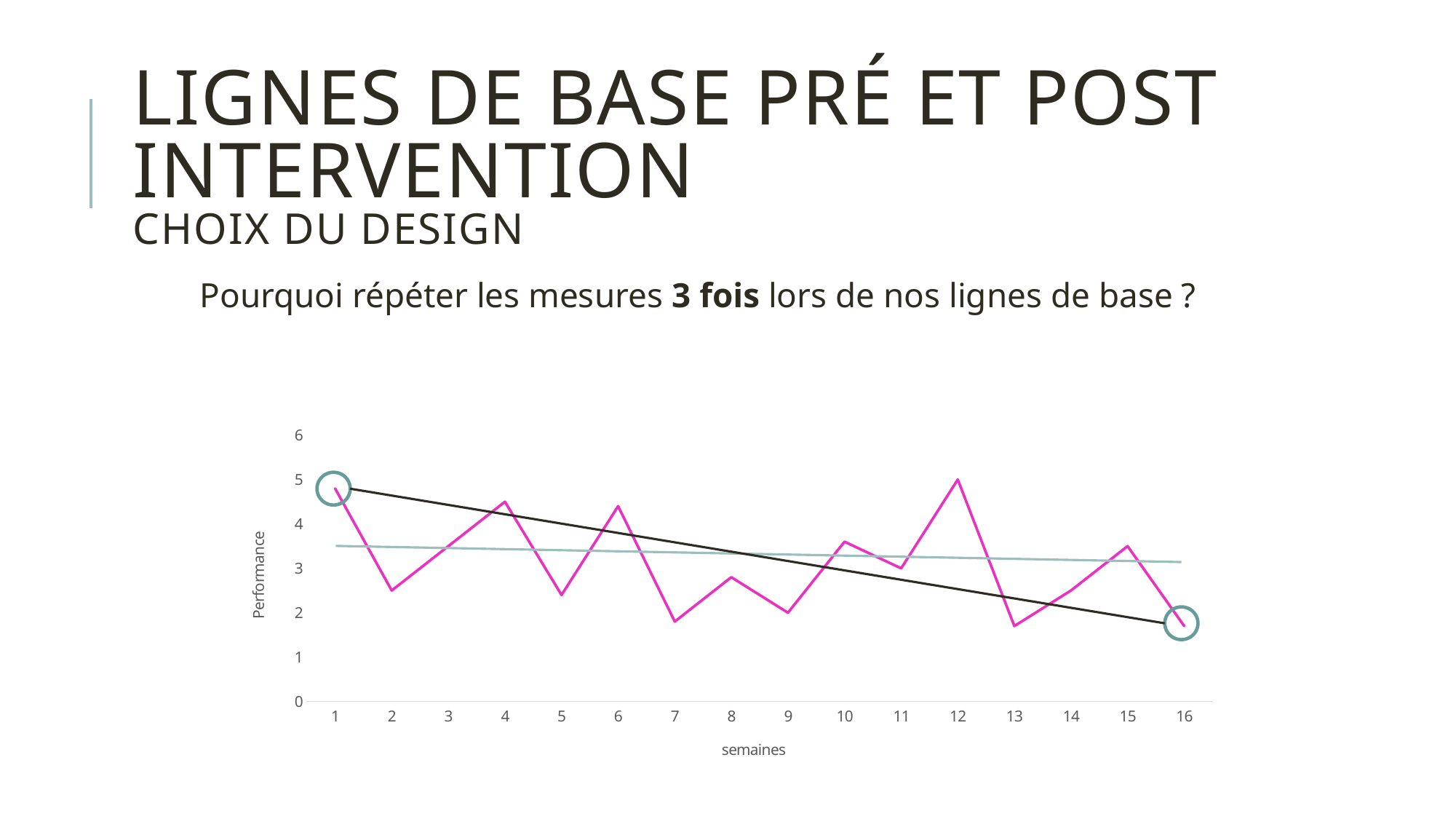
Is the performance value for week 2 greater or less than 3? less Does the black straight line from week 1 to week 16 rise or fall across the chart? fall What is the label of the y axis? Performance What is the label of the x axis? semaines Is the performance value for week 12 greater or less than 4? greater Is the performance value for week 4 greater or less than 4? greater Which week has the higher performance value, week 12 or week 13? week 12 How many weeks (points) are plotted along the x axis? 16 What kind of chart is shown on the slide? line chart Which week has the higher performance value, week 4 or week 5? week 4